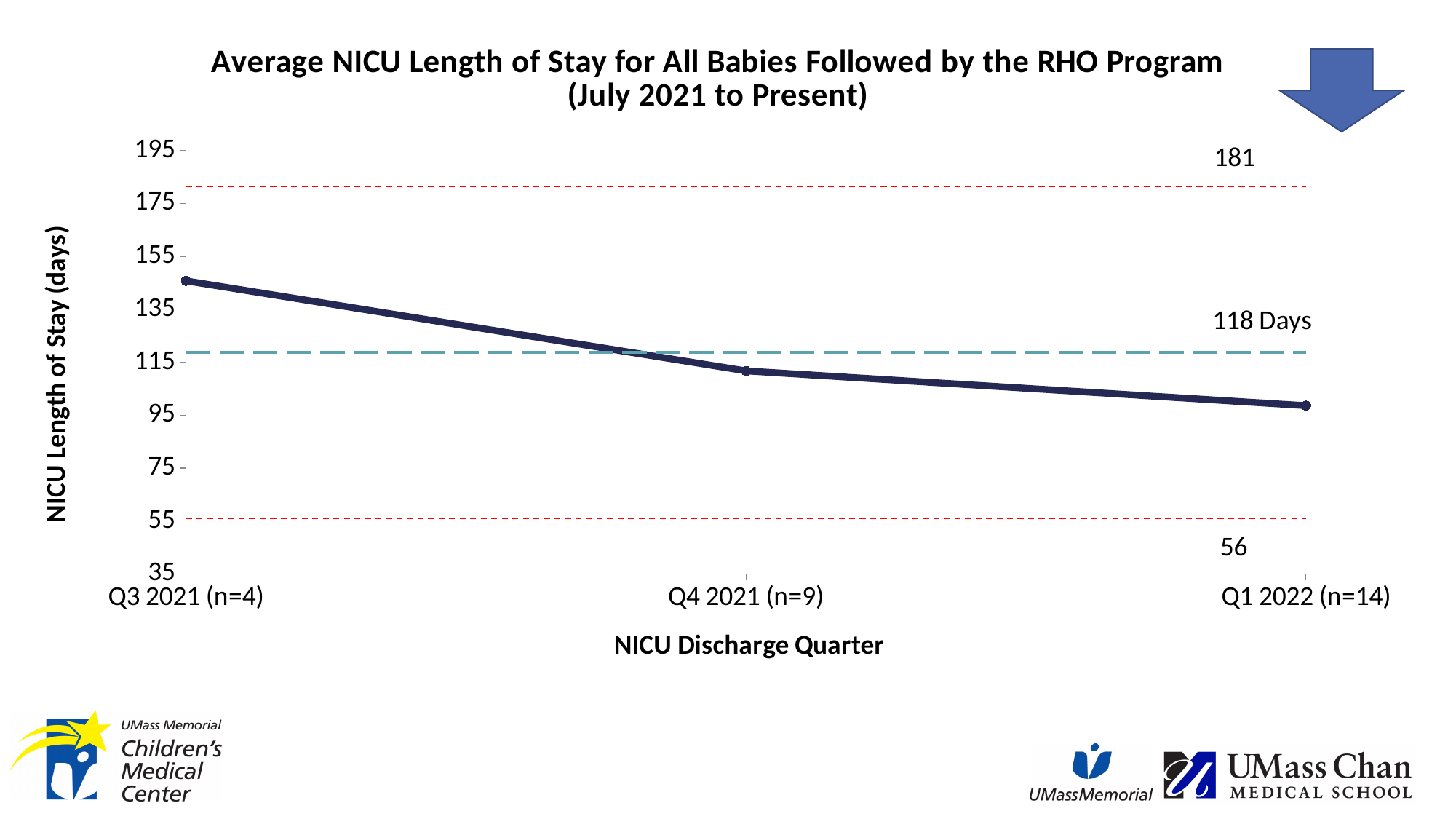
Which quarter has the highest average NICU length of stay? Q3 2021 (n=4) Is the value for Q3 2021 (n=4) greater or less than 135? greater What kind of chart is shown on the slide? line chart Is the value for Q1 2022 (n=14) greater or less than 115? less Do the average NICU length of stay values rise or fall from Q3 2021 to Q1 2022? fall Which quarter has a larger average NICU length of stay, Q4 2021 (n=9) or Q1 2022 (n=14)? Q4 2021 (n=9) How many quarters are plotted on the x axis? 3 What is the label of the x axis? NICU Discharge Quarter Is the value for Q4 2021 (n=9) greater or less than 115? less What value is labelled on the blue dashed reference line? 118 Days Which quarter has the lowest average NICU length of stay? Q1 2022 (n=14)